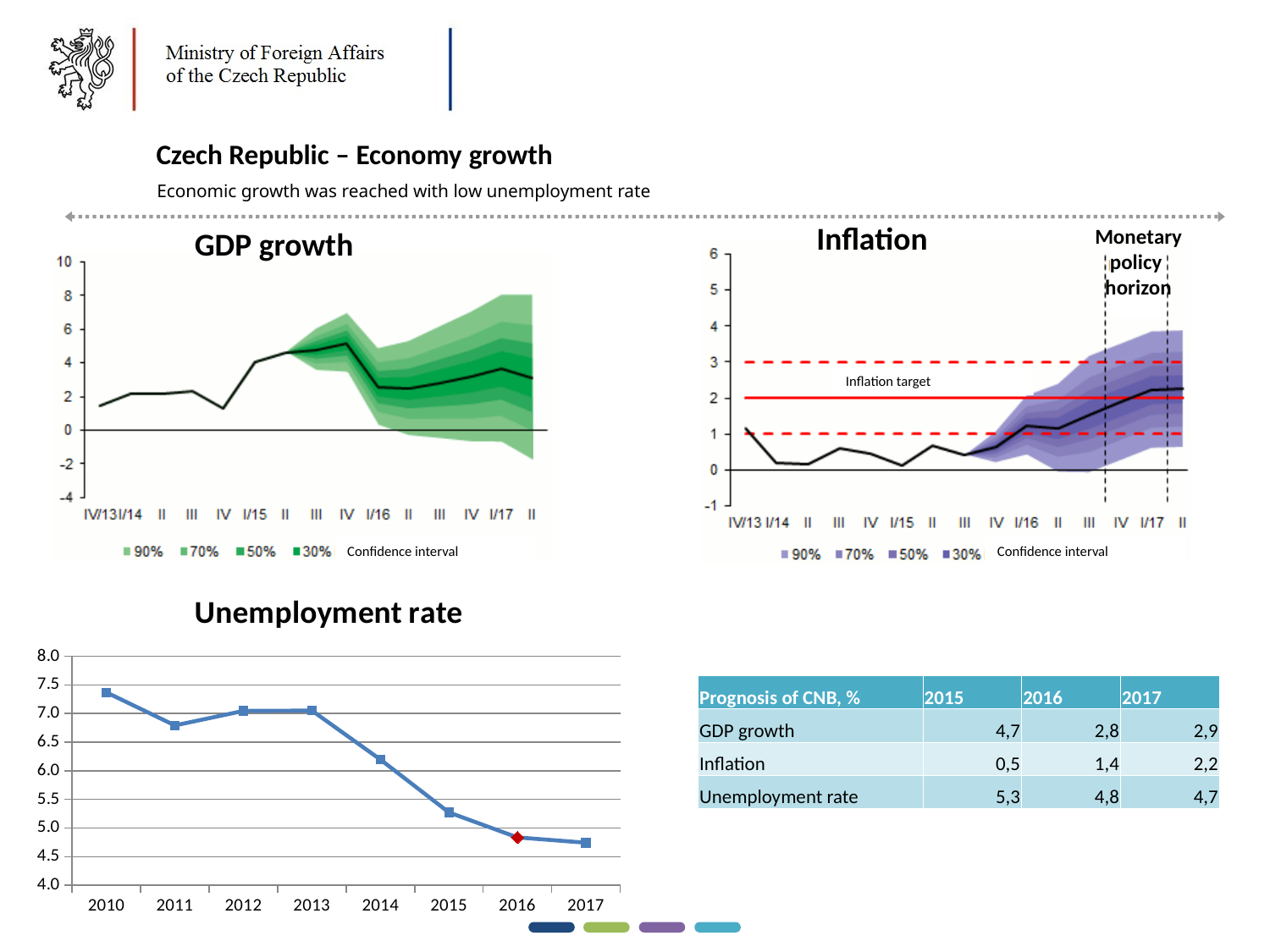
In the Unemployment rate chart, which is larger, the value for 2012 or the value for 2014? 2012 In the Unemployment rate chart, is the value for 2017 greater or less than 5.0? less In the GDP growth chart, how many confidence interval levels does the legend list? 4 In the Unemployment rate chart, which year has the highest unemployment rate? 2010 In the Unemployment rate chart, how many years are plotted on the x axis? 8 In the Inflation chart, at what value on the y axis is the solid red inflation target line drawn? 2 What colour are the confidence interval bands in the Inflation chart? purple What kind of chart is the Unemployment rate chart? line chart In the Unemployment rate chart, is the value for 2010 greater or less than 7.0? greater In the Unemployment rate chart, is the value for 2015 greater or less than 5.5? less In the Unemployment rate chart, do the values generally rise or fall from 2010 to 2017? fall